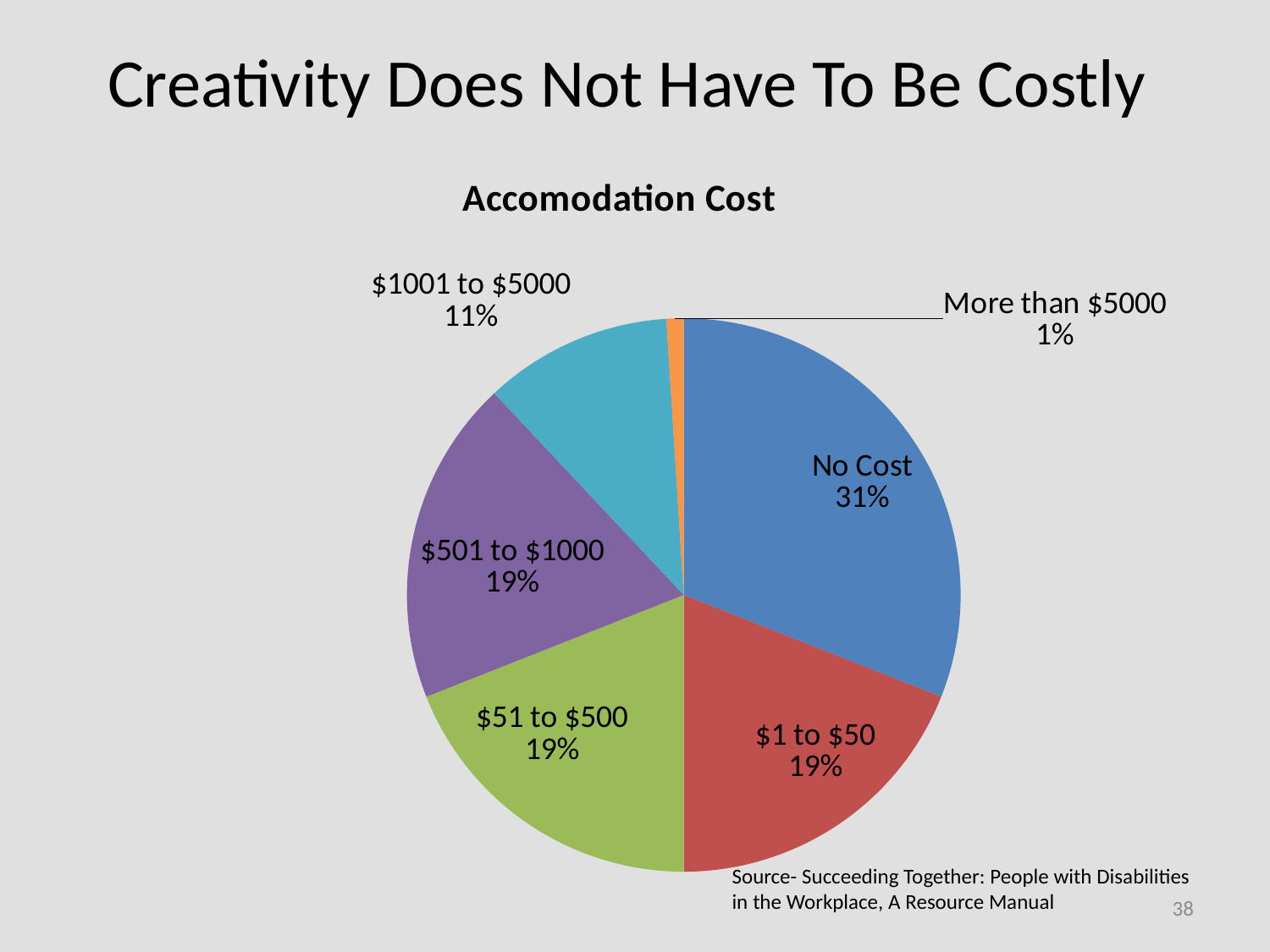
What is the title of the chart? Accomodation Cost What share of the pie is labelled No Cost? 31% How many slices does the pie chart have? 6 What percentage is shown for the $1001 to $5000 slice? 11% What is the difference in percentage points between the No Cost slice and the $1001 to $5000 slice? 20 Which category has the smallest share of the pie? More than $5000 What percentage is shown for the More than $5000 slice? 1% What percentage is shown for the $501 to $1000 slice? 19% Which category has the largest share of the pie? No Cost What kind of chart is shown on the slide? pie chart What colour is the No Cost slice? blue Which is larger, the share for $1 to $50 or the share for $1001 to $5000? $1 to $50